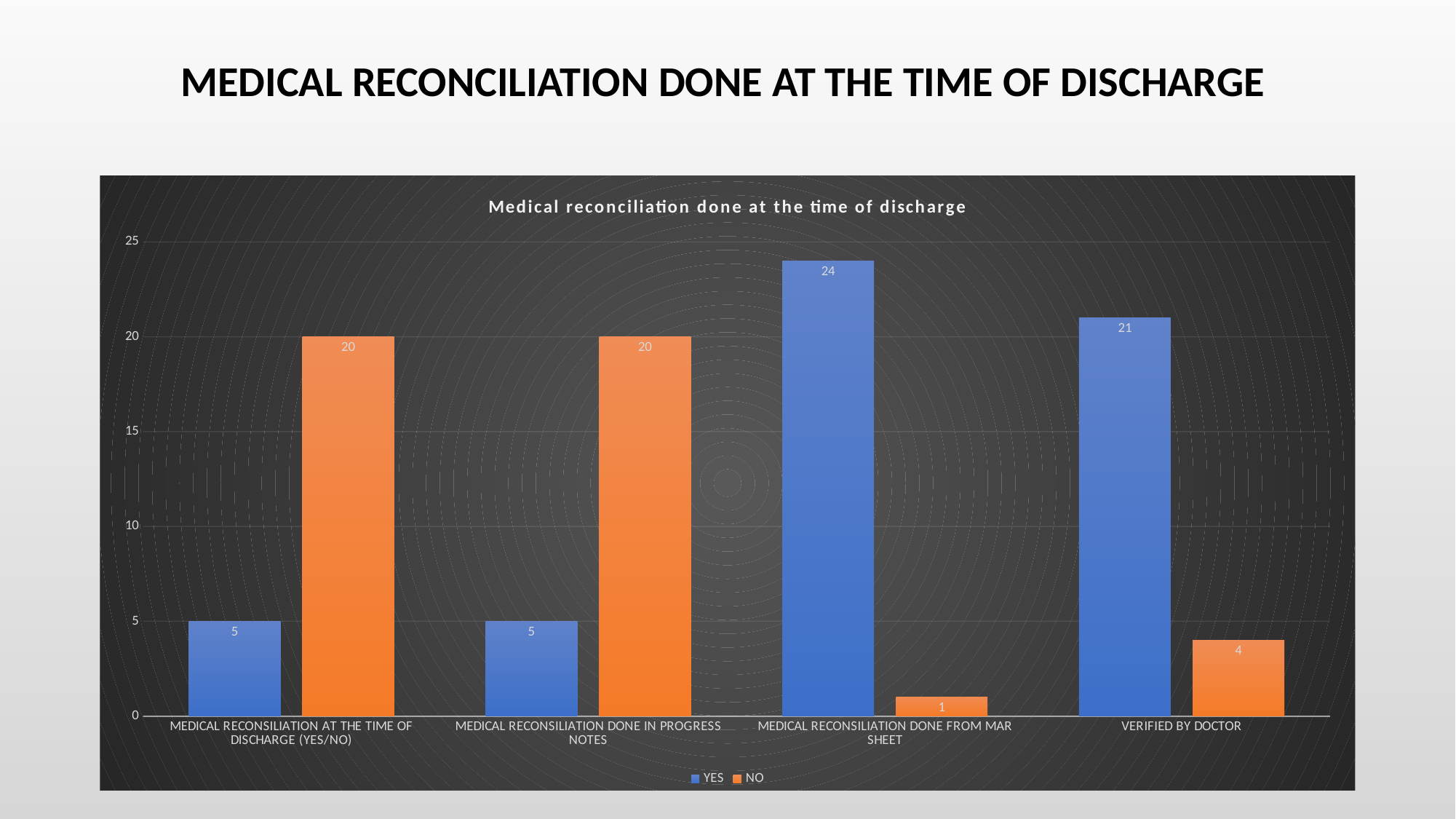
What is the YES value for VERIFIED BY DOCTOR? 21 How many categories are shown on the x axis? 4 What colour represents the NO series in the chart? Orange Which is larger for VERIFIED BY DOCTOR, the YES value or the NO value? YES What is the YES value for MEDICAL RECONSILIATION DONE FROM MAR SHEET? 24 What is the NO value for VERIFIED BY DOCTOR? 4 How many series does the legend list? 2 Which category has the highest YES value? MEDICAL RECONSILIATION DONE FROM MAR SHEET What is the difference between the NO and YES values for MEDICAL RECONSILIATION AT THE TIME OF DISCHARGE (YES/NO)? 15 What kind of chart is shown on the slide? Bar chart What is the NO value for MEDICAL RECONSILIATION DONE IN PROGRESS NOTES? 20 Which category has the lowest NO value? MEDICAL RECONSILIATION DONE FROM MAR SHEET